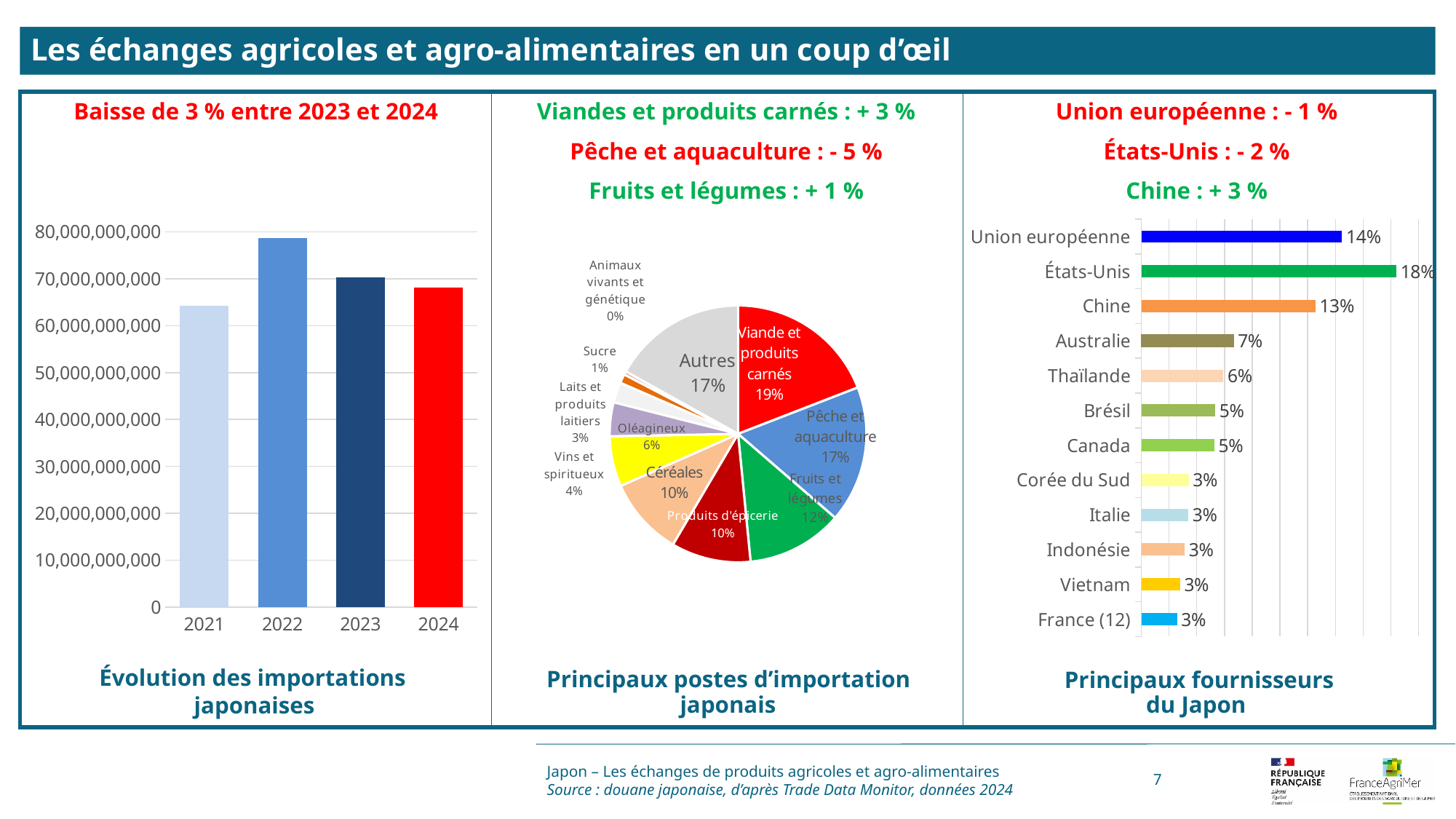
In the 'Principaux fournisseurs du Japon' chart, which is larger, Australie or Thaïlande? Australie In the 'Principaux postes d'importation japonais' pie chart, what share does 'Viande et produits carnés' have? 19% In the 'Évolution des importations japonaises' chart, is the value for 2021 greater or less than 70,000,000,000? less How many years are shown in the 'Évolution des importations japonaises' chart? 4 In the 'Évolution des importations japonaises' chart, which year has the highest bar? 2022 In the 'Évolution des importations japonaises' chart, is the value for 2022 greater or less than 70,000,000,000? greater In the 'Principaux fournisseurs du Japon' chart, which supplier has the highest value? États-Unis In the 'Évolution des importations japonaises' chart, which year has the lowest bar? 2021 What kind of chart is the 'Évolution des importations japonaises' chart on the left? bar chart In the 'Principaux postes d'importation japonais' pie chart, what is the difference between 'Viande et produits carnés' and 'Fruits et légumes'? 7% In the 'Principaux fournisseurs du Japon' chart, what is the value for Chine? 13% In the 'Principaux postes d'importation japonais' pie chart, what is the value for 'Pêche et aquaculture'? 17%